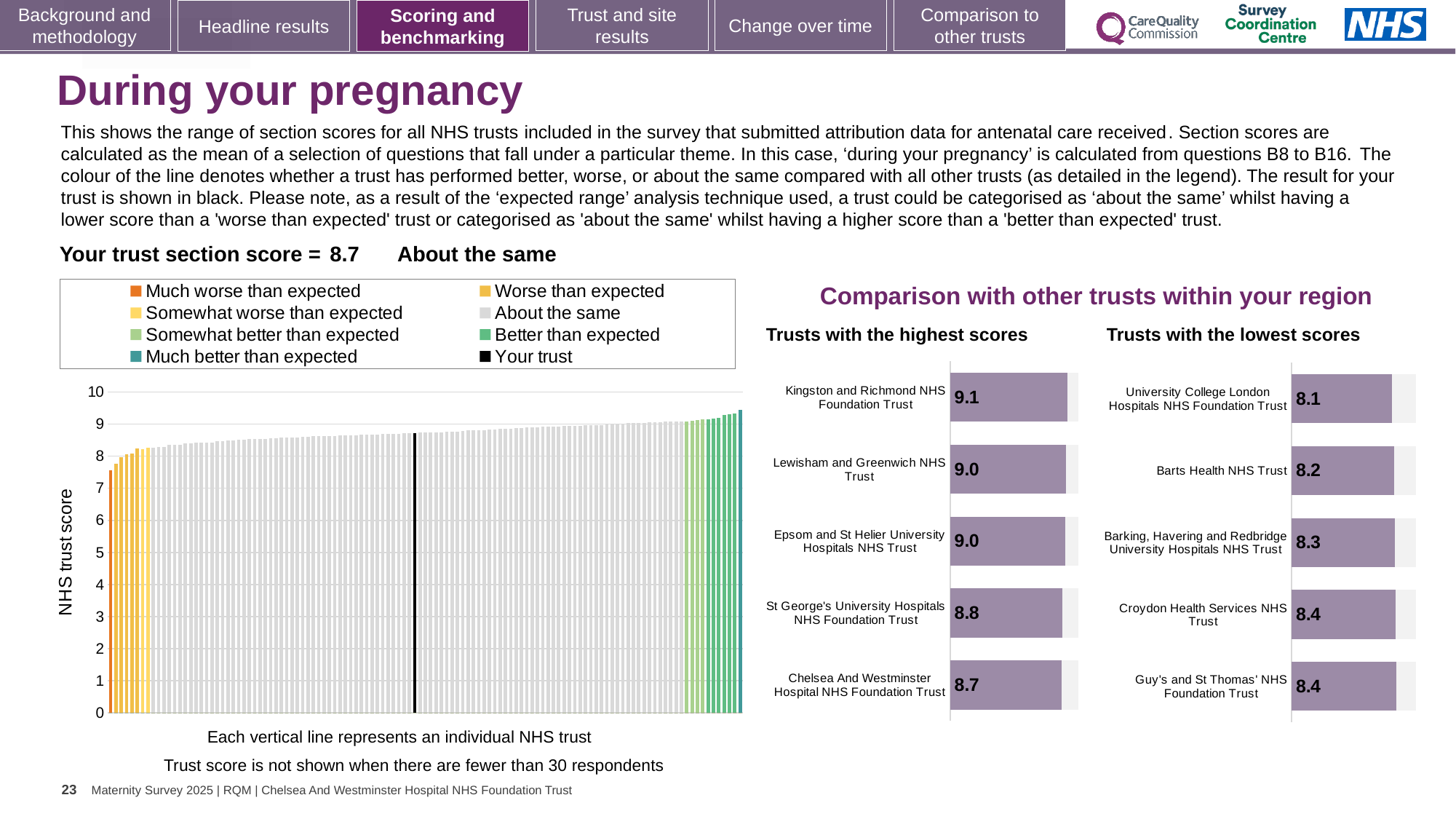
In the 'Trusts with the highest scores' chart, what is the score for Kingston and Richmond NHS Foundation Trust? 9.1 In the 'Trusts with the highest scores' chart, what is the difference between the scores of Kingston and Richmond NHS Foundation Trust and Chelsea And Westminster Hospital NHS Foundation Trust? 0.4 In the 'Trusts with the lowest scores' chart, what is the score for Barts Health NHS Trust? 8.2 In the left-hand NHS trust score chart, do the values rise or fall from left to right along the x axis? rise In the 'Trusts with the lowest scores' chart, what is the difference between the scores of Guy's and St Thomas' NHS Foundation Trust and University College London Hospitals NHS Foundation Trust? 0.3 What kind of chart is the left-hand chart showing NHS trust scores? bar chart In the 'Trusts with the lowest scores' chart, which trust has the lowest score? University College London Hospitals NHS Foundation Trust In the 'Trusts with the highest scores' chart, what is the score for Chelsea And Westminster Hospital NHS Foundation Trust? 8.7 In the 'Trusts with the highest scores' chart, which trust has the highest score? Kingston and Richmond NHS Foundation Trust How many trusts are shown in the 'Trusts with the highest scores' chart? 5 Which has a higher score: St George's University Hospitals NHS Foundation Trust in the highest scores chart, or Croydon Health Services NHS Trust in the lowest scores chart? St George's University Hospitals NHS Foundation Trust How many entries does the legend of the left-hand NHS trust score chart list? 8